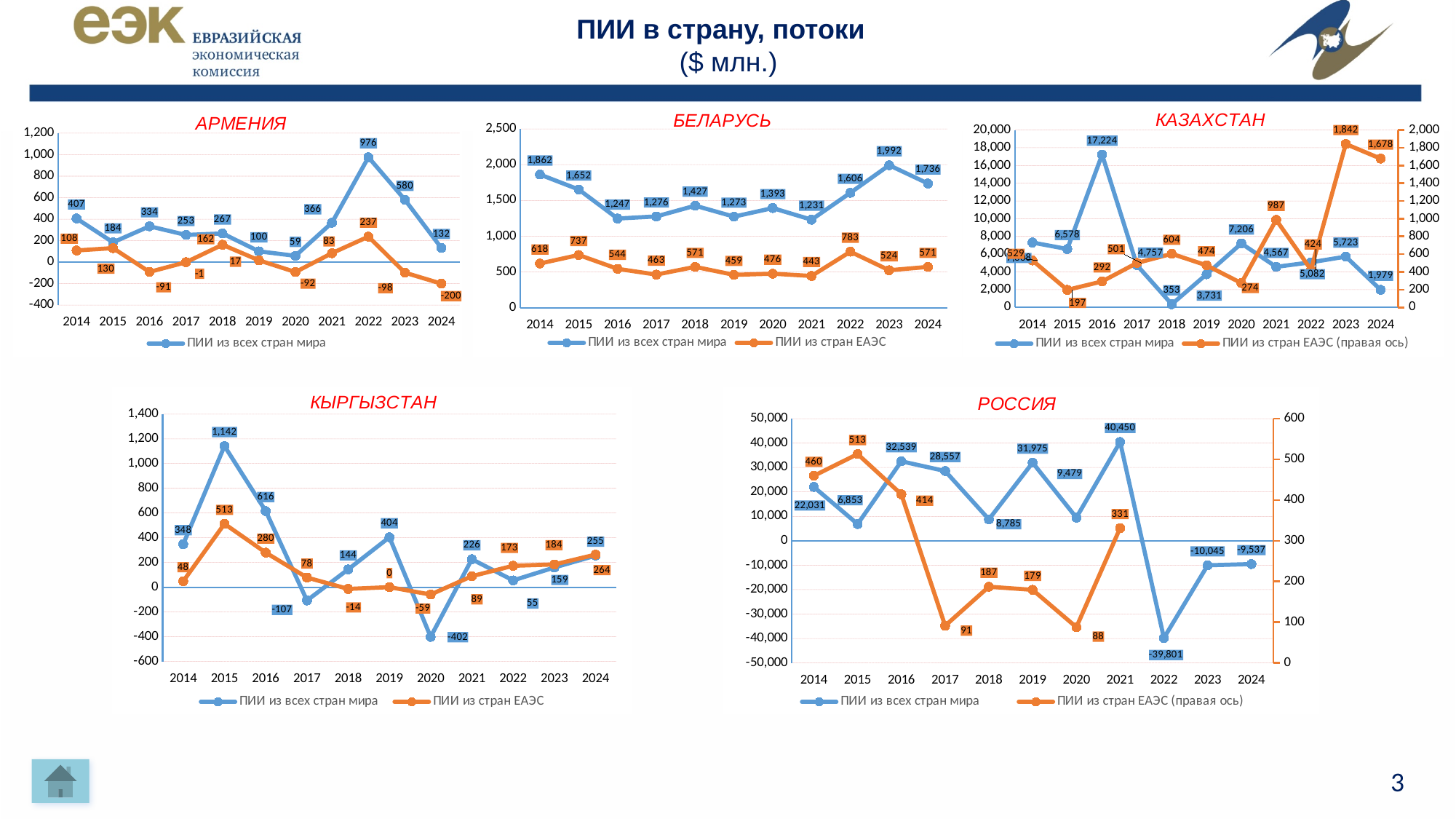
On the РОССИЯ chart, what is the value of ПИИ из всех стран мира in 2022? -39,801 On the РОССИЯ chart, how many series does the legend list? 2 On the БЕЛАРУСЬ chart, what is the value of ПИИ из стран ЕАЭС in 2022? 783 On the БЕЛАРУСЬ chart, in which year is ПИИ из всех стран мира highest? 2023 On the АРМЕНИЯ chart, what is the value of ПИИ из всех стран мира in 2022? 976 On the АРМЕНИЯ chart, in which year is ПИИ из всех стран мира lowest? 2020 What kind of chart is the РОССИЯ chart? Line chart On the КЫРГЫЗСТАН chart, which is larger in 2015: ПИИ из всех стран мира or ПИИ из стран ЕАЭС? ПИИ из всех стран мира On the БЕЛАРУСЬ chart, what is the difference between ПИИ из всех стран мира in 2023 and in 2024? 256 On the КАЗАХСТАН chart, in which year is ПИИ из стран ЕАЭС (правая ось) highest? 2023 On the КАЗАХСТАН chart, what is the value of ПИИ из всех стран мира in 2016? 17,224 On the КЫРГЫЗСТАН chart, what is the value of ПИИ из всех стран мира in 2020? -402